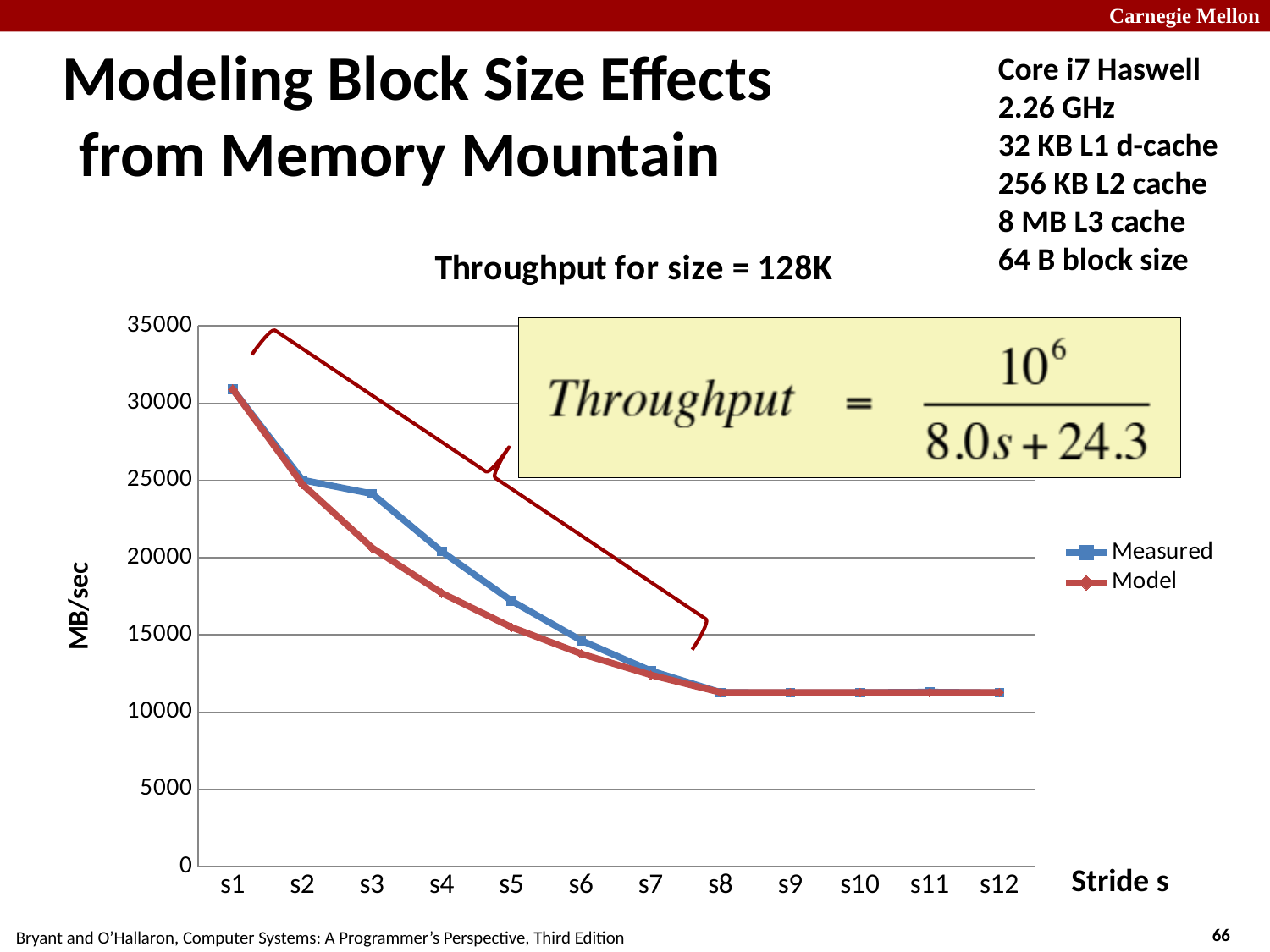
At which stride is the Measured throughput highest? s1 How many stride values are plotted along the x axis? 12 What is the title of the chart? Throughput for size = 128K What kind of chart is shown on the slide? line chart Is the Model value at s4 greater or less than 20000? less Is the Measured value at s1 greater or less than 30000? greater What is the label of the y axis? MB/sec Is the Measured value at s8 greater or less than 10000? greater How many series does the chart legend list? 2 Do the Measured values rise or fall as the stride increases from s1 to s8? fall At stride s3, which series has the larger value, Measured or Model? Measured